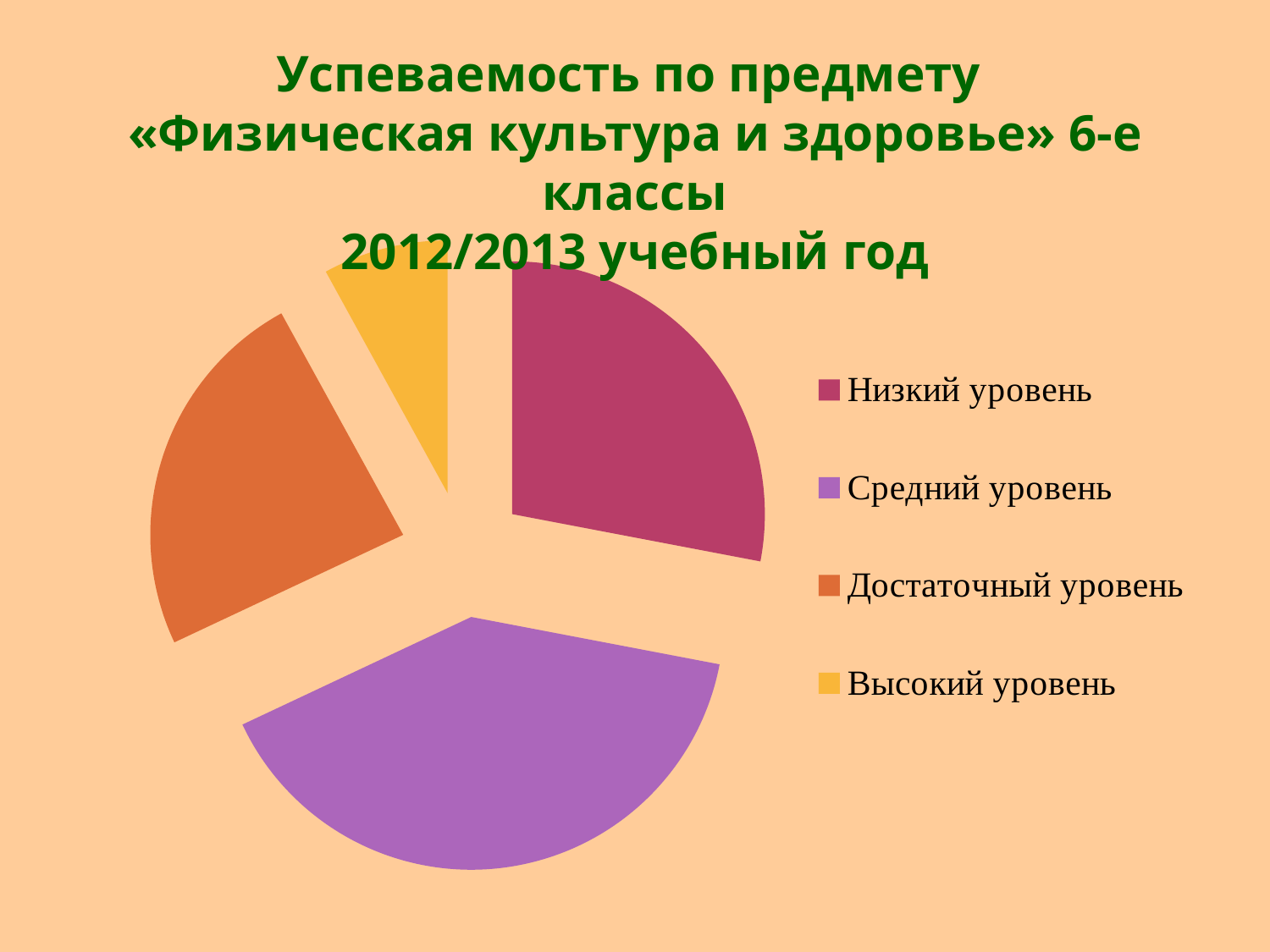
How many entries does the legend of the pie chart list? 4 What kind of chart is shown on the slide? Pie chart Which slice is larger, Средний уровень or Низкий уровень? Средний уровень What colour is the slice for Высокий уровень in the pie chart? Yellow How many slices does the pie chart have? 4 Which slice is larger, Средний уровень or Высокий уровень? Средний уровень Which slice is larger, Достаточный уровень or Высокий уровень? Достаточный уровень Which category has the largest slice in the pie chart? Средний уровень Which school year does the chart title refer to? 2012/2013 учебный год Which category has the smallest slice in the pie chart? Высокий уровень